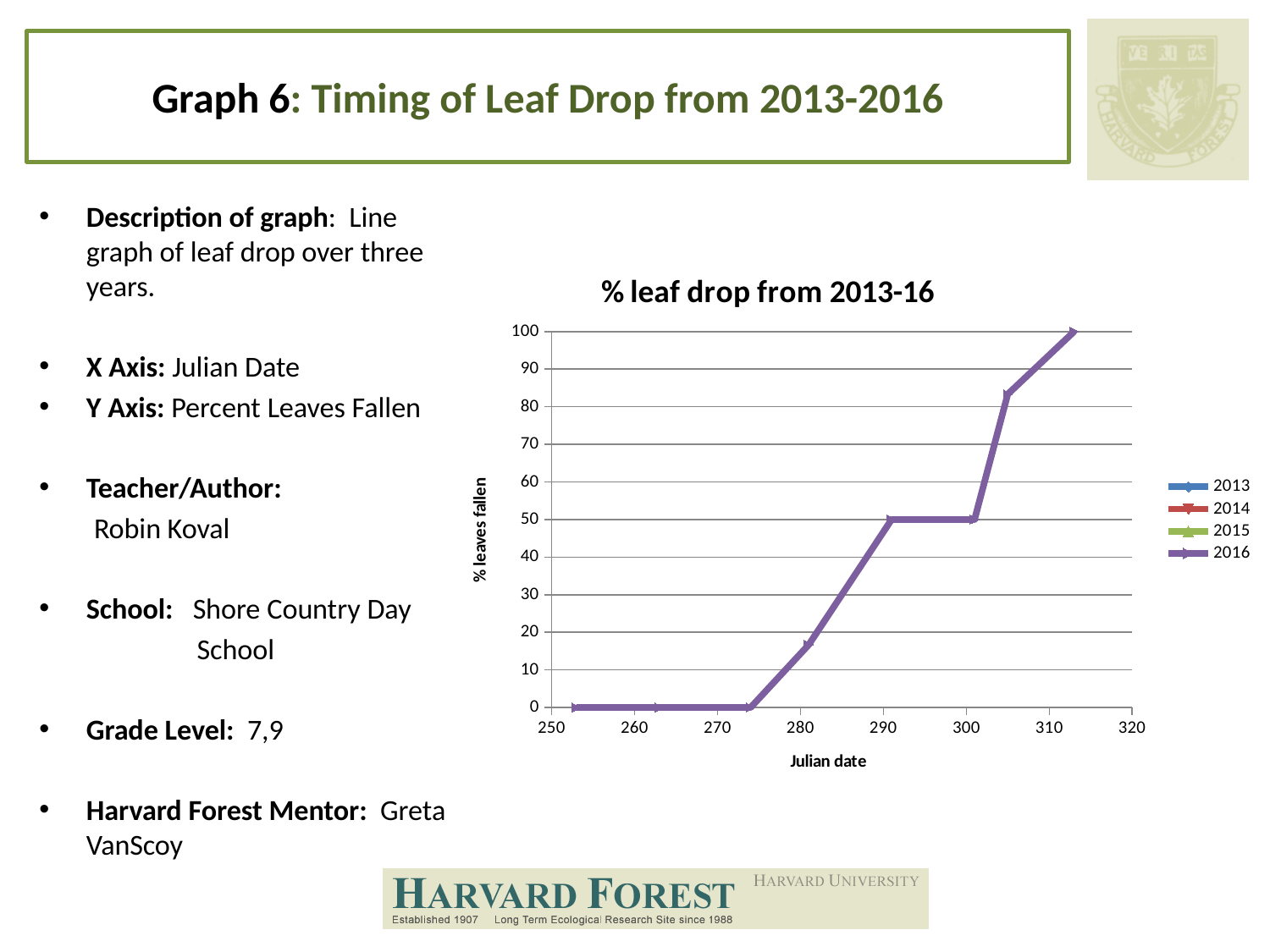
Is the value of the 2016 line at Julian date 291 greater or less than 40? greater What is the title of the chart? % leaf drop from 2013-16 How many data points are plotted on the 2016 line? 8 What is the lowest value on the 2016 line? 0 Which is larger on the 2016 line: the value at Julian date 281 or the value at Julian date 305? Julian date 305 What is the label on the x axis of the chart? Julian date Do the values of the 2016 line rise or fall as the Julian date increases? Rise How many series does the chart legend list? 4 Is the value of the 2016 line at Julian date 305 greater or less than 70? greater What kind of chart is shown on the slide? Line chart Is the value of the 2016 line at Julian date 281 greater or less than 30? less What is the highest value reached by the 2016 line? 100